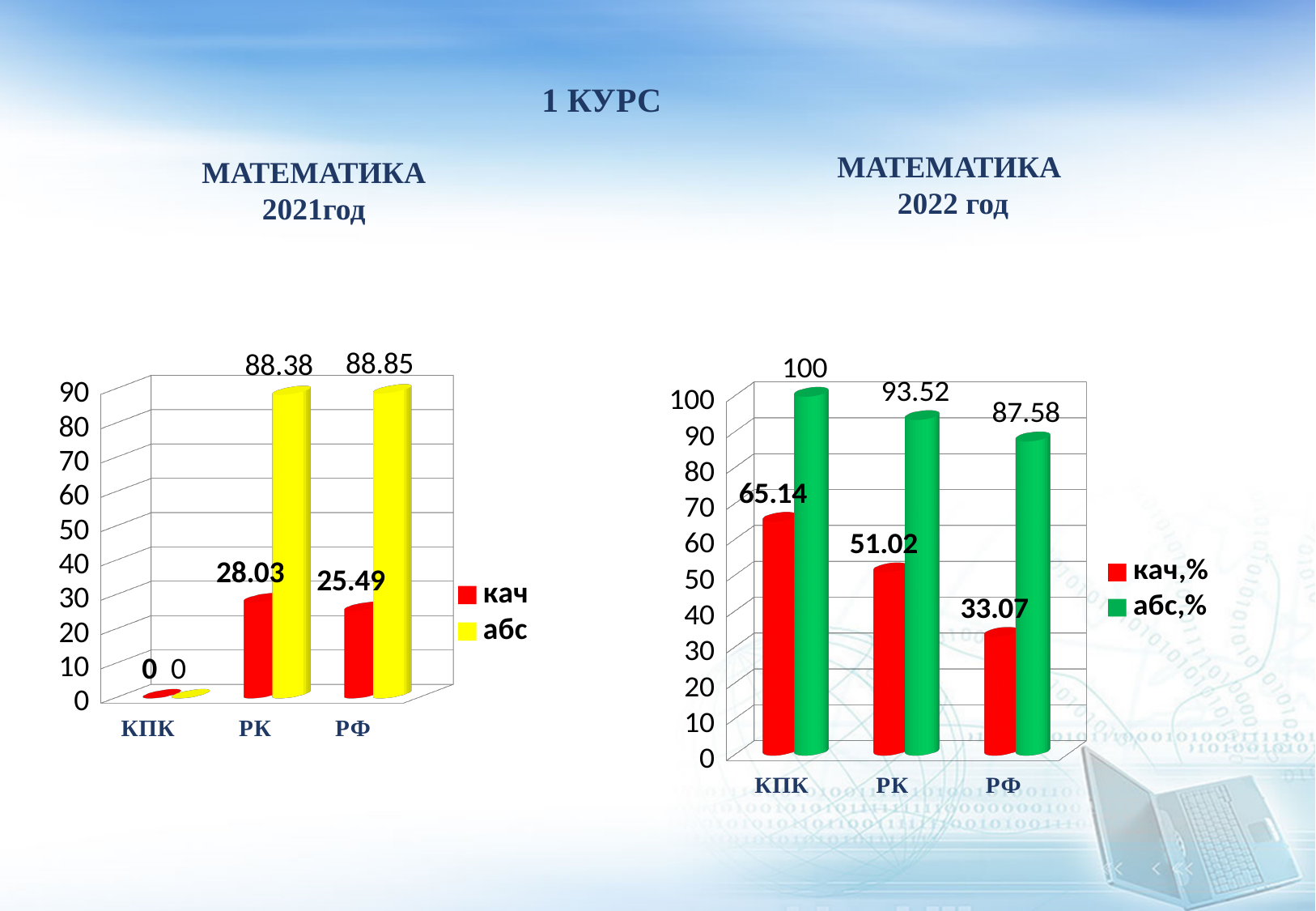
In the МАТЕМАТИКА 2022 год chart, which category has the lowest кач,% value? РФ In the МАТЕМАТИКА 2021год chart, what is the difference between the кач values for РК and РФ? 2.54 In the МАТЕМАТИКА 2021год chart, what is the абс value for РК? 88.38 How many series does the legend of the МАТЕМАТИКА 2022 год chart list? 2 In the МАТЕМАТИКА 2022 год chart, is the кач,% value for РК larger or the кач,% value for РФ? РК In the МАТЕМАТИКА 2022 год chart, what is the абс,% value for РФ? 87.58 In the МАТЕМАТИКА 2021год chart, what is the кач value for РФ? 25.49 In the МАТЕМАТИКА 2021год chart, what is the кач value for КПК? 0 What kind of chart is the МАТЕМАТИКА 2021год chart? Bar chart In the МАТЕМАТИКА 2022 год chart, what is the difference between the абс,% values for КПК and РК? 6.48 In the МАТЕМАТИКА 2022 год chart, what is the кач,% value for КПК? 65.14 In the МАТЕМАТИКА 2021год chart, which category has the highest абс value? РФ